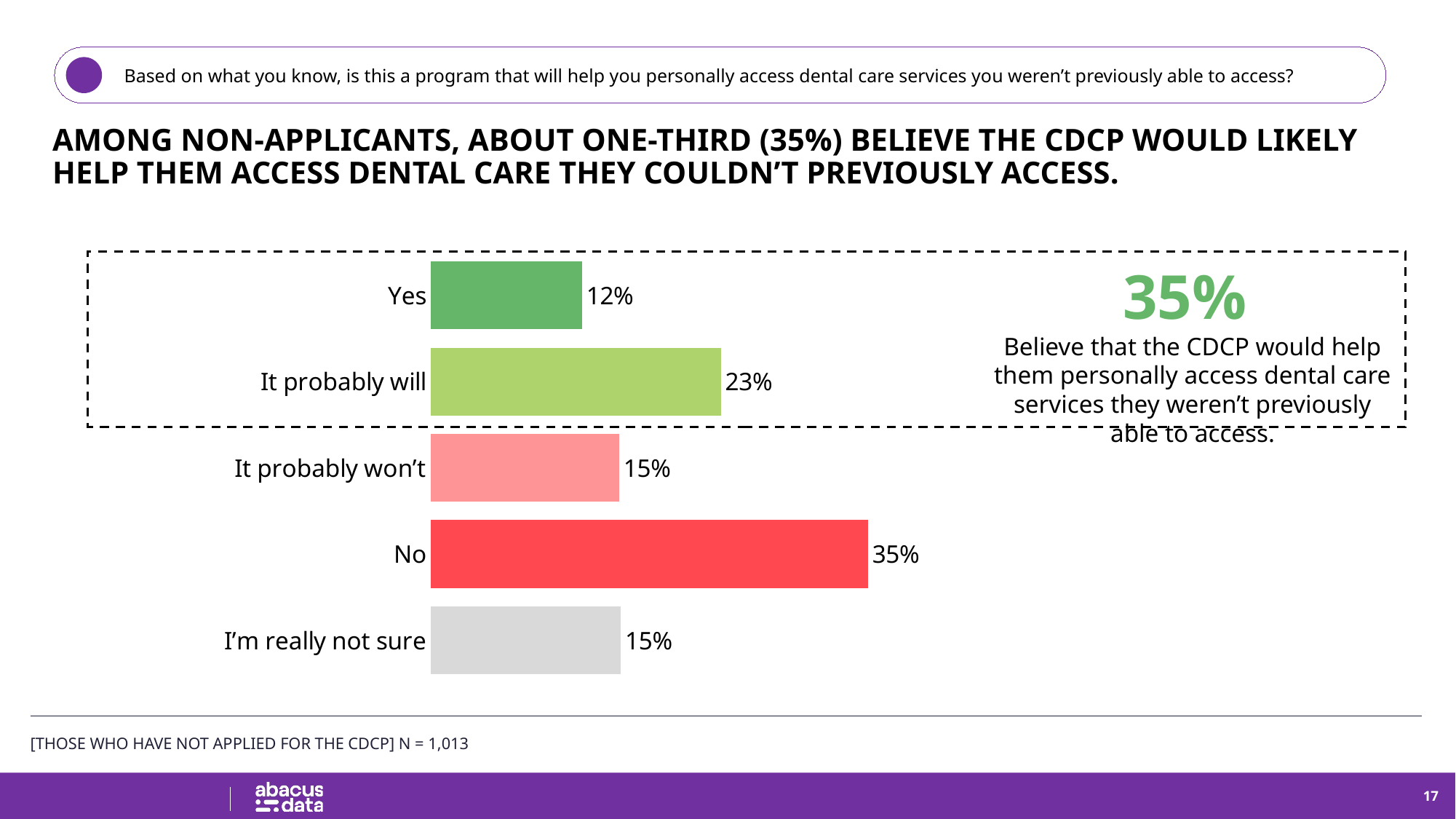
Which response category has the lowest percentage? Yes What percentage of non-applicants answered "Yes"? 12% What is the difference in percentage points between "It probably will" and "It probably won't"? 8 What is the difference in percentage points between "No" and "Yes"? 23 What percentage of non-applicants answered "It probably will"? 23% Which is larger, the value for "It probably will" or the value for "It probably won't"? It probably will What percentage of non-applicants answered "No"? 35% Which response category has the highest percentage? No What is the combined percentage of "Yes" and "It probably will" responses? 35% What percentage of non-applicants answered "I'm really not sure"? 15% What type of chart is shown on the slide? Bar chart How many response categories are shown in the chart? 5